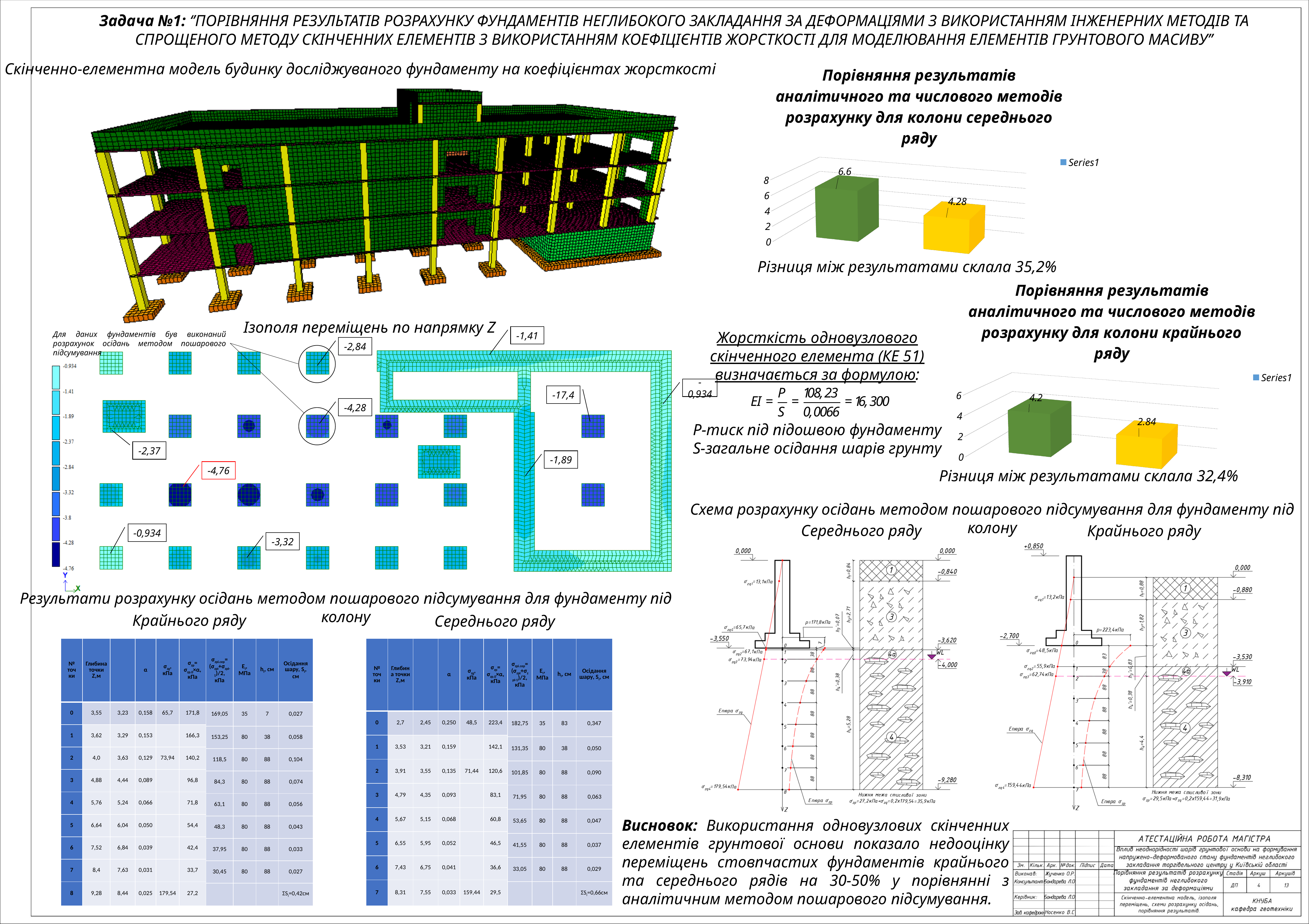
In the chart titled 'Порівняння результатів аналітичного та числового методів розрахунку для колони крайнього ряду', what is the value of the right (yellow) bar? 2.84 In the chart titled 'Порівняння результатів аналітичного та числового методів розрахунку для колони середнього ряду', what is the value of the right (yellow) bar? 4.28 How many bars are plotted in the chart for the column of the middle row (середнього ряду)? 2 What is the legend entry shown in the chart for the column of the edge row (крайнього ряду)? Series1 In the chart titled 'Порівняння результатів аналітичного та числового методів розрахунку для колони середнього ряду', what is the value of the left (green) bar? 6.6 What kind of chart is used for the comparison of analytical and numerical methods for the column of the middle row (середнього ряду)? bar chart In the chart for the column of the middle row (середнього ряду), which bar is higher, the left green one or the right yellow one? the left green bar In the chart titled 'Порівняння результатів аналітичного та числового методів розрахунку для колони крайнього ряду', what is the value of the left (green) bar? 4.2 In the chart for the column of the edge row (крайнього ряду), what is the difference between the two bar values? 1.36 In the chart for the column of the middle row (середнього ряду), what is the difference between the two bar values? 2.32 In the chart for the column of the edge row (крайнього ряду), what is the lowest bar value? 2.84 How many series does the legend list in the chart for the column of the edge row (крайнього ряду)? 1